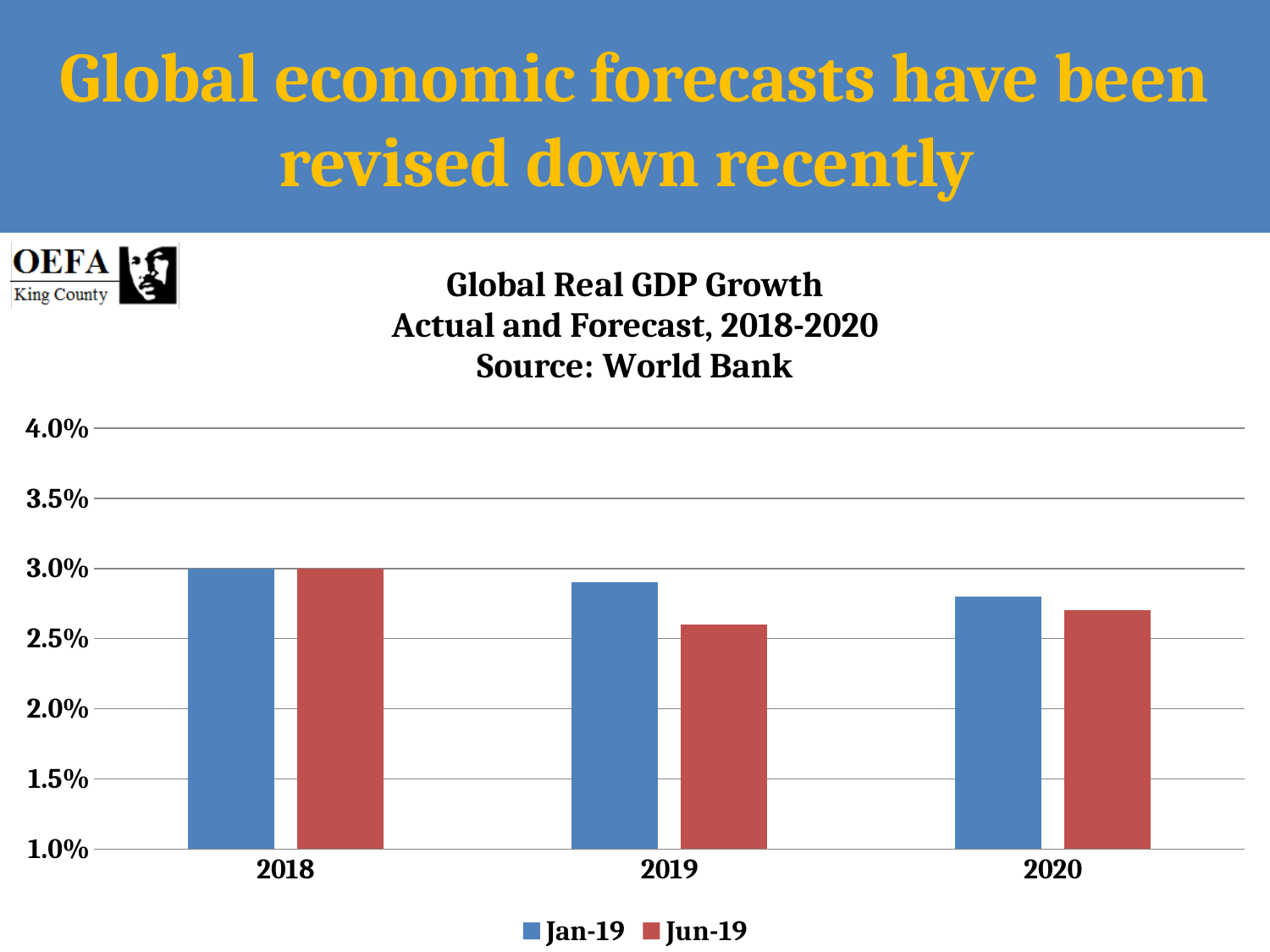
What source is cited in the chart title? World Bank Is the Jun-19 value for 2020 greater or less than 3.0%? less Which year has the lowest Jun-19 value? 2019 Is the Jun-19 value for 2019 greater or less than 3.0%? less How many series does the legend list? 2 What type of chart is shown on the slide? Bar chart What is the Jan-19 value for 2018? 3.0% For 2019, which is larger, the Jan-19 value or the Jun-19 value? Jan-19 How many years are shown on the x axis? 3 Is the Jan-19 value for 2019 greater or less than 2.5%? greater What is the Jun-19 value for 2018? 3.0% Do the Jan-19 values rise or fall from 2018 to 2020? Fall